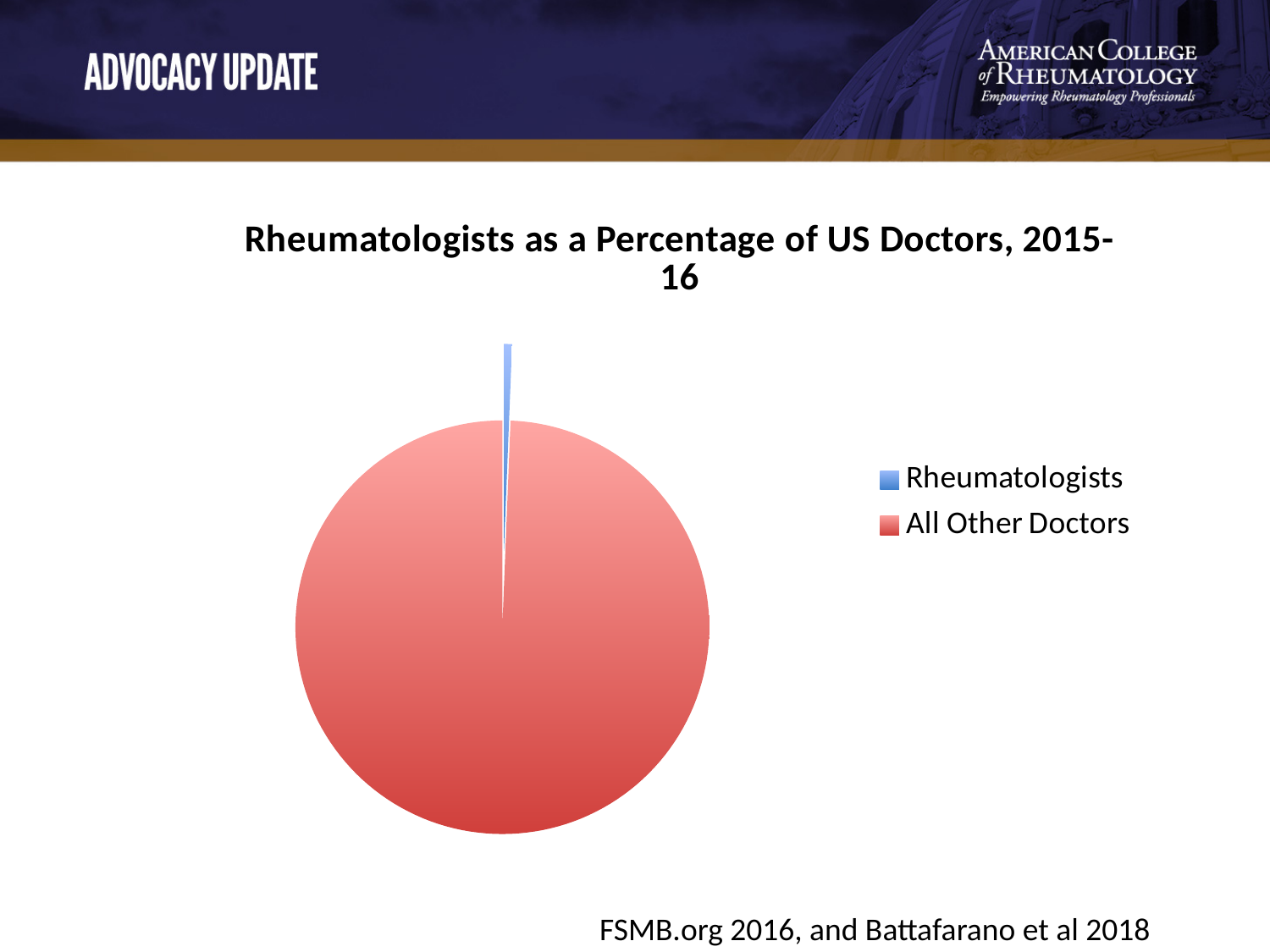
Which category has the largest slice of the pie chart? All Other Doctors What kind of chart is shown on the slide? pie chart What is the title of the pie chart? Rheumatologists as a Percentage of US Doctors, 2015-16 What colour is the Rheumatologists slice in the pie chart? blue How many entries does the legend of the pie chart list? 2 How many slices does the pie chart have? 2 Which slice is larger, Rheumatologists or All Other Doctors? All Other Doctors Which category has the smallest slice of the pie chart? Rheumatologists